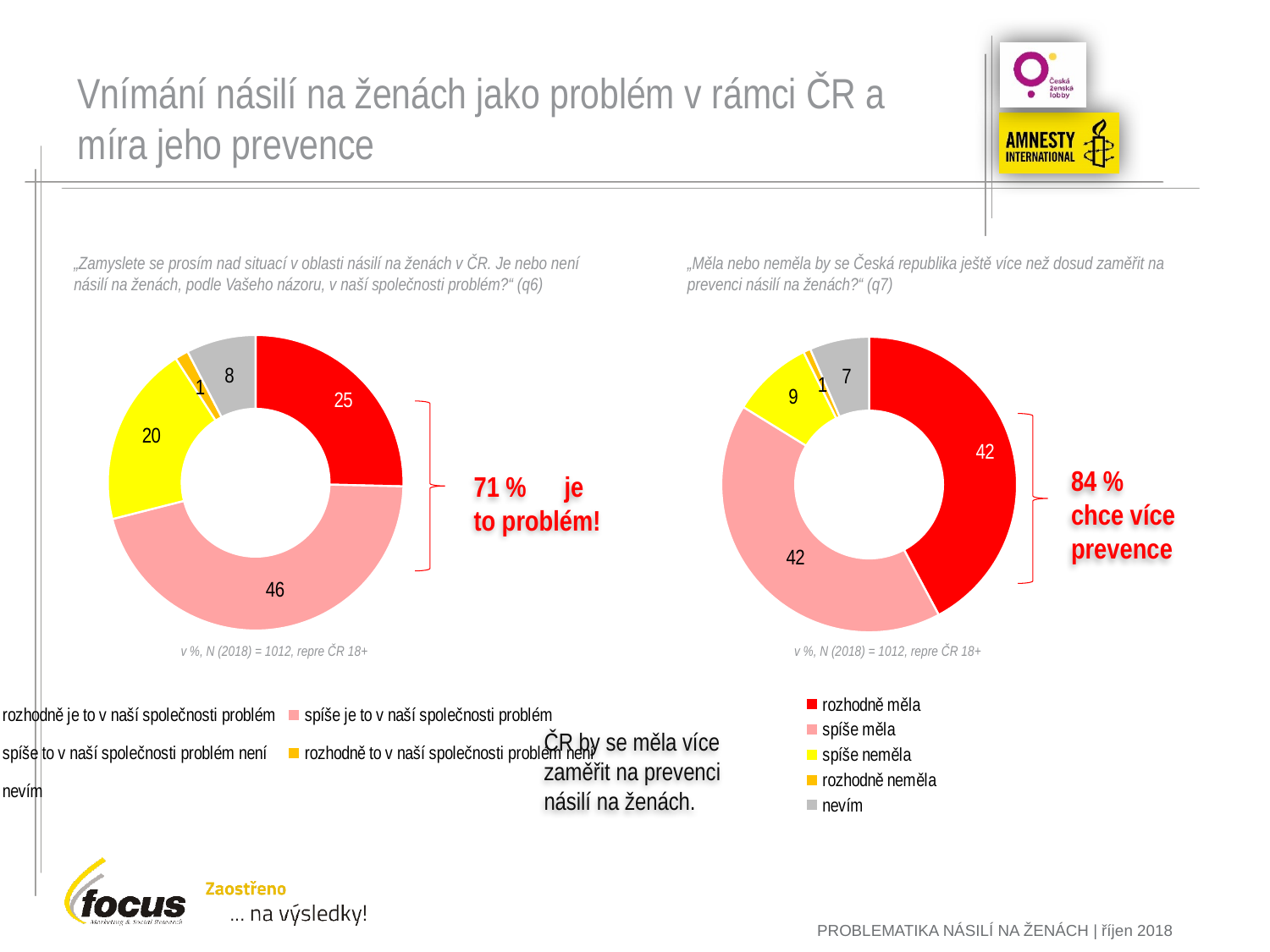
In the left chart, which segment has the smallest value? rozhodně to v naší společnosti problém není In the left chart, what value is shown for the pink segment 'spíše je to v naší společnosti problém'? 46 What type of chart is used on the left side of the slide? Doughnut (pie) chart In the left chart, what is the difference between the 'spíše je to problém' segment (46) and the 'rozhodně je to problém' segment (25)? 21 In the right chart, what value is shown for the grey segment 'nevím'? 7 In the left chart, which segment has the largest value? spíše je to v naší společnosti problém How many entries does the legend of the right chart list? 5 In the left chart, what value is shown for the red segment 'rozhodně je to v naší společnosti problém'? 25 In the right chart, which segment has the smallest value? rozhodně neměla In the right chart, what is the combined value of the 'rozhodně měla' and 'spíše měla' segments? 84 In the left chart, is the value for 'nevím' larger or smaller than the value for 'spíše to v naší společnosti problém není'? smaller In the right chart, what value is shown for the yellow segment 'spíše neměla'? 9